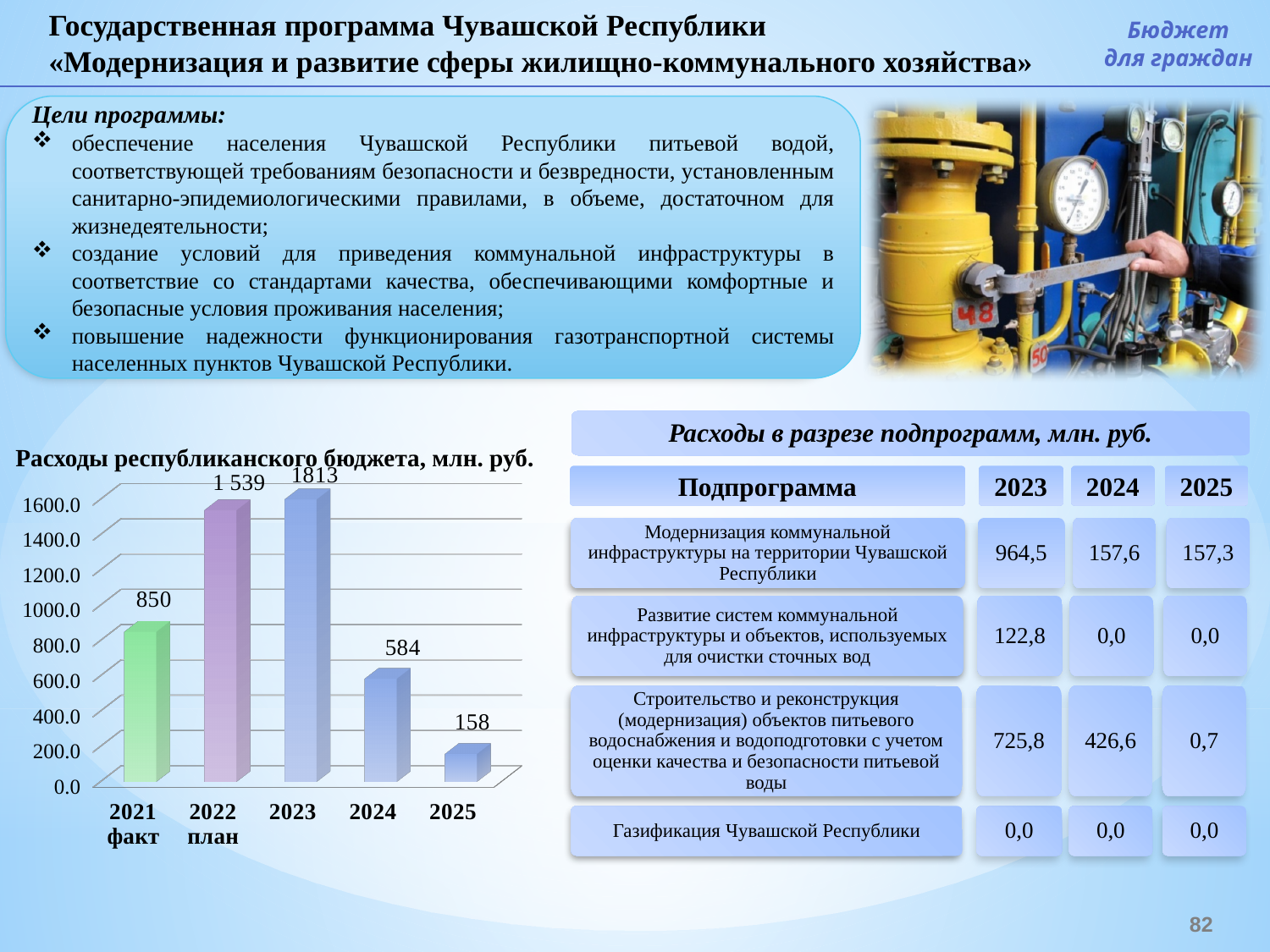
What is the value for 2024 in the chart 'Расходы республиканского бюджета, млн. руб.'? 584 What is the value for 2022 in the chart 'Расходы республиканского бюджета, млн. руб.'? 1 539 Which year has the highest value in the chart 'Расходы республиканского бюджета, млн. руб.'? 2023 Which year has the lowest value in the chart 'Расходы республиканского бюджета, млн. руб.'? 2025 What is the value for 2023 in the chart 'Расходы республиканского бюджета, млн. руб.'? 1813 How many years are shown in the chart 'Расходы республиканского бюджета, млн. руб.'? 5 What is the value for 2021 in the chart 'Расходы республиканского бюджета, млн. руб.'? 850 What kind of chart is 'Расходы республиканского бюджета, млн. руб.'? bar chart What is the value for 2025 in the chart 'Расходы республиканского бюджета, млн. руб.'? 158 Which is larger in the chart 'Расходы республиканского бюджета, млн. руб.': the value for 2021 or the value for 2024? 2021 Do the values rise or fall from 2023 to 2025 in the chart 'Расходы республиканского бюджета, млн. руб.'? fall What is the difference between the values for 2023 and 2022 in the chart 'Расходы республиканского бюджета, млн. руб.'? 274